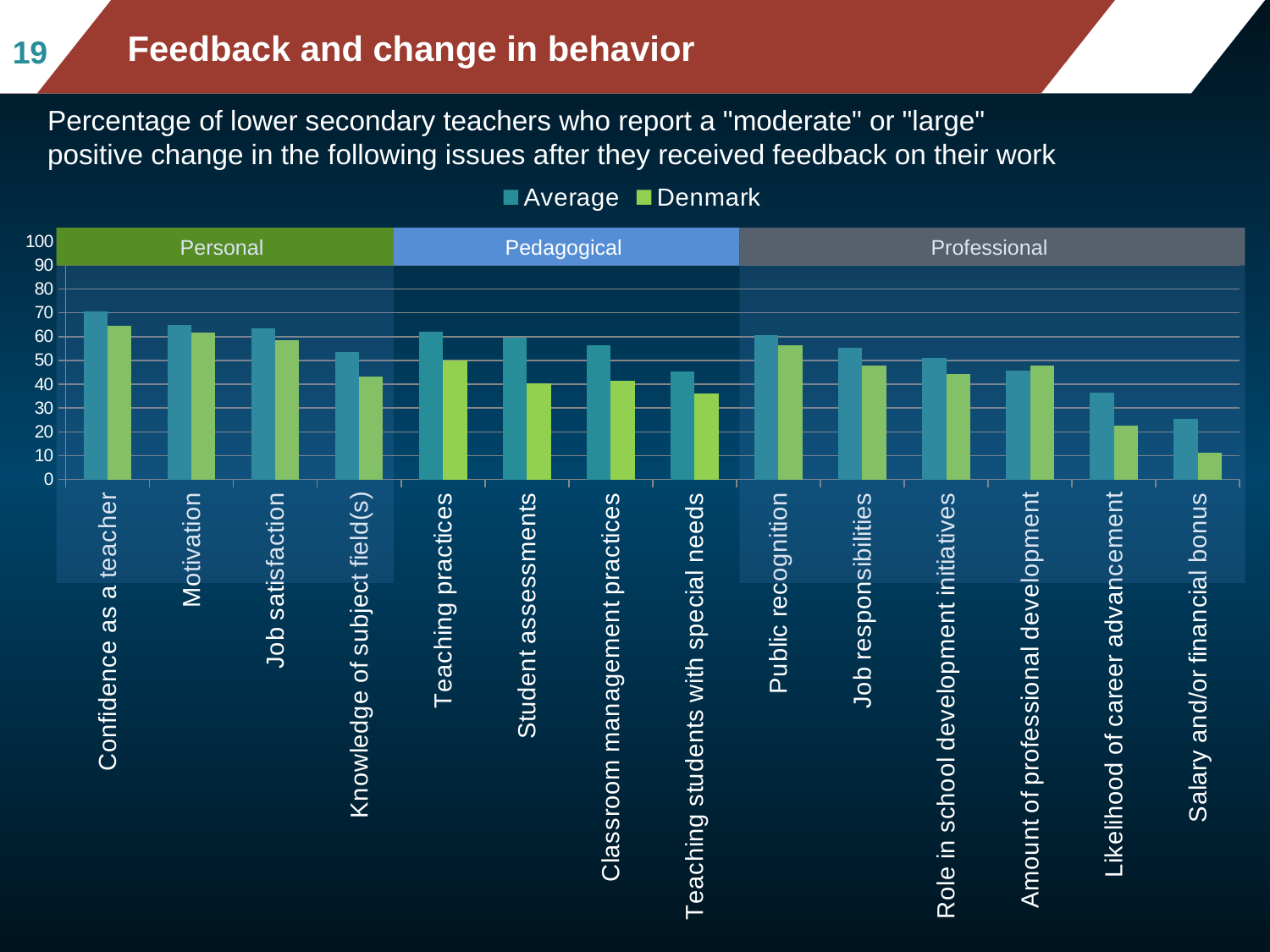
Which category has the highest Average value? Confidence as a teacher Is the Denmark value for Teaching students with special needs greater or less than 50? less Is the Average value for Confidence as a teacher greater or less than 60? greater For Student assessments, which series has the larger value, Average or Denmark? Average Which category has the lowest Denmark value? Salary and/or financial bonus What are the three group headings shown across the top of the chart? Personal, Pedagogical, Professional What are the two series named in the legend? Average and Denmark How many categories are plotted along the x axis? 14 Is the Denmark value for Salary and/or financial bonus greater or less than 20? less What kind of chart is shown on the slide? bar chart How many series does the legend list? 2 For Likelihood of career advancement, which series has the larger value, Average or Denmark? Average